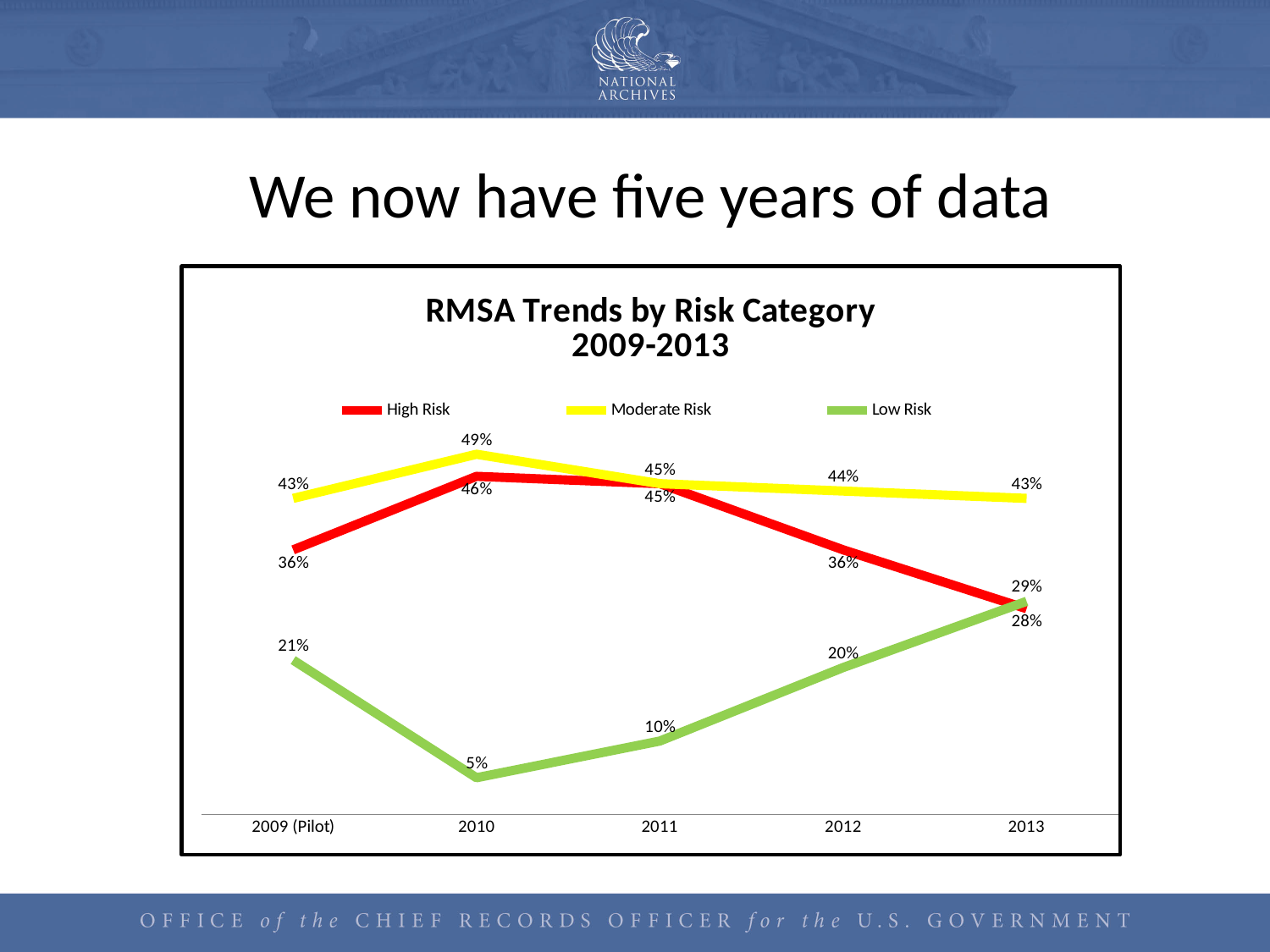
Which is larger in 2012, the High Risk value or the Low Risk value? High Risk Does the Low Risk value rise or fall from 2010 to 2013? Rise What is the Low Risk value for 2013? 29% What is the difference between the High Risk values for 2010 and 2013? 18% In which year is the Low Risk value lowest? 2010 What type of chart is shown on the slide? Line chart What is the title of the chart? RMSA Trends by Risk Category 2009-2013 How many series does the legend list? 3 What is the Moderate Risk value for 2012? 44% In which year is the Moderate Risk value highest? 2010 How many years are plotted along the x axis? 5 What is the High Risk value for 2010? 46%